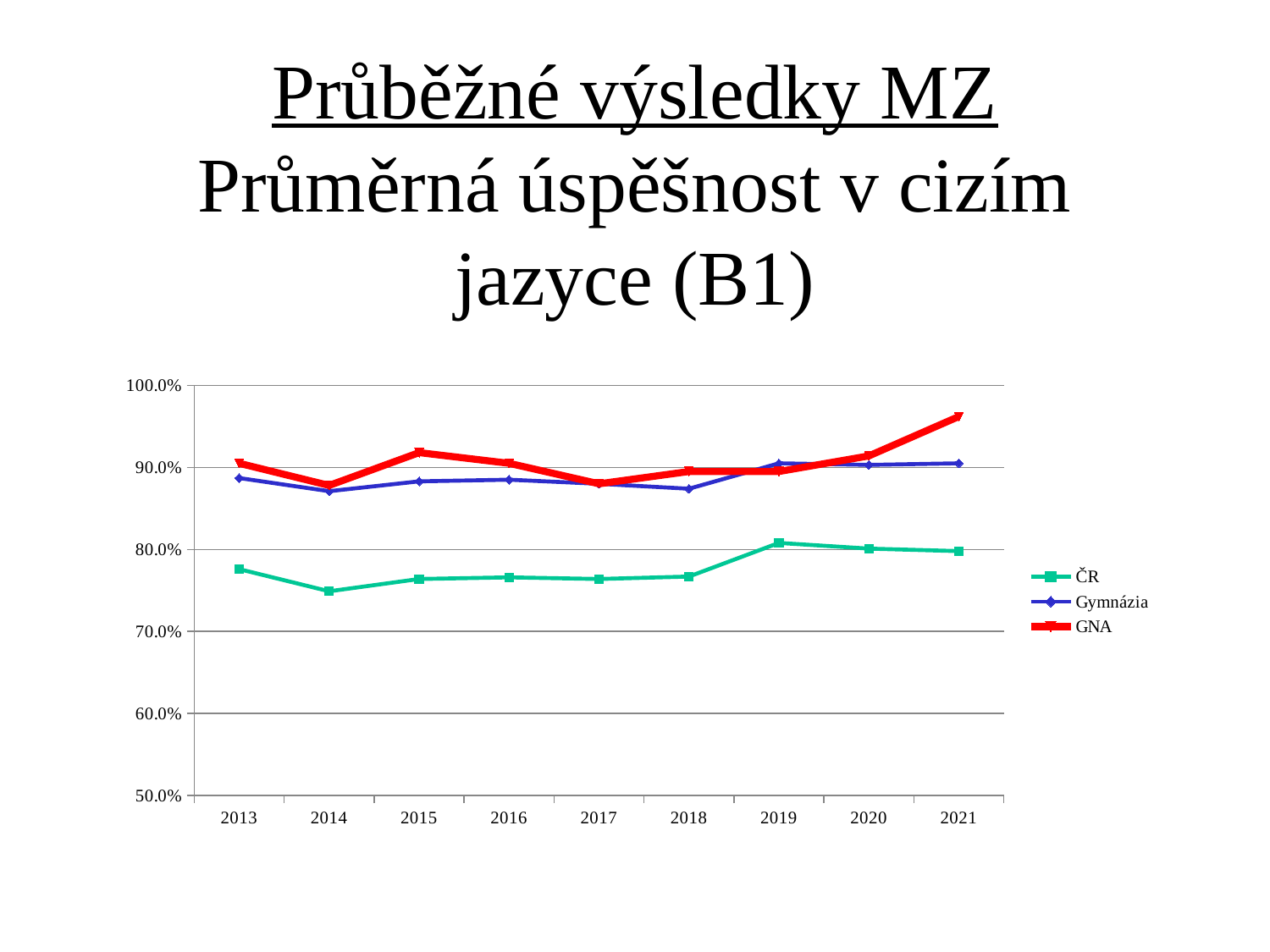
Is the value for Gymnázia in 2013 greater or less than 90.0%? less Which series has the larger value in 2021, GNA or ČR? GNA Does the GNA series rise or fall from 2019 to 2021? rise In which year does the ČR series have its highest value? 2019 Which series is shown with the red line? GNA In which year does the ČR series have its lowest value? 2014 Is the value for ČR in 2014 greater or less than 80.0%? less What kind of chart is shown on the slide? line chart How many series does the legend list? 3 How many years are plotted along the x axis? 9 In which year does the GNA series reach its highest value? 2021 Is the value for GNA in 2021 greater or less than 90.0%? greater